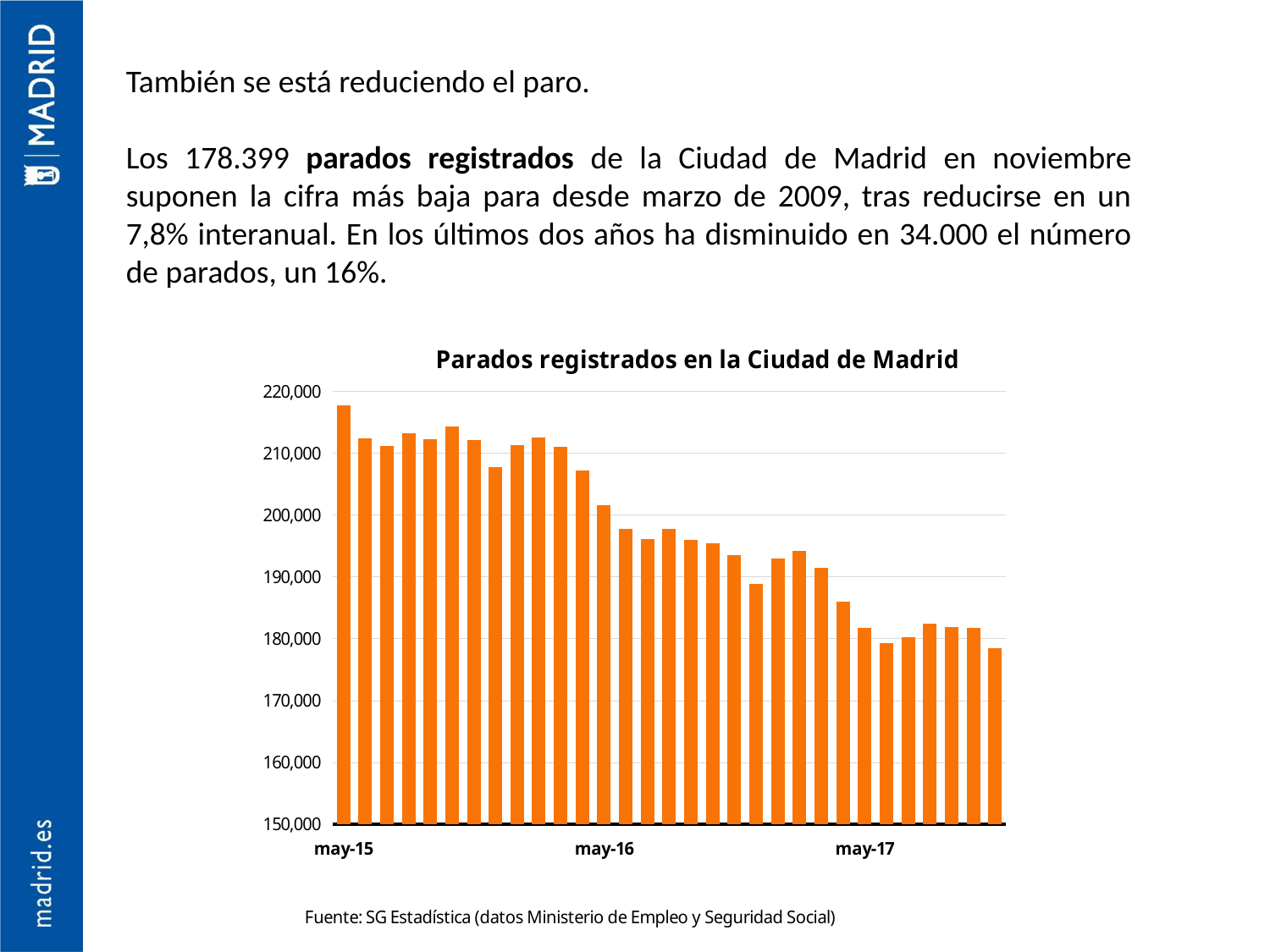
Is the value for may-17 greater or less than 190,000? less What colour are the bars in the chart? orange Is the value for may-16 greater or less than 210,000? less Which of the labelled months (may-15, may-16, may-17) has the highest value? may-15 Is the value of the last bar in the chart greater or less than 180,000? less What is the title of the chart? Parados registrados en la Ciudad de Madrid Which of the labelled months (may-15, may-16, may-17) has the lowest value? may-17 Which is larger, the value for may-16 or the value for may-17? may-16 How many bars are plotted in the chart? 31 What kind of chart is shown on the slide? bar chart Do the values in the chart generally rise or fall from may-15 to the end of the series? fall